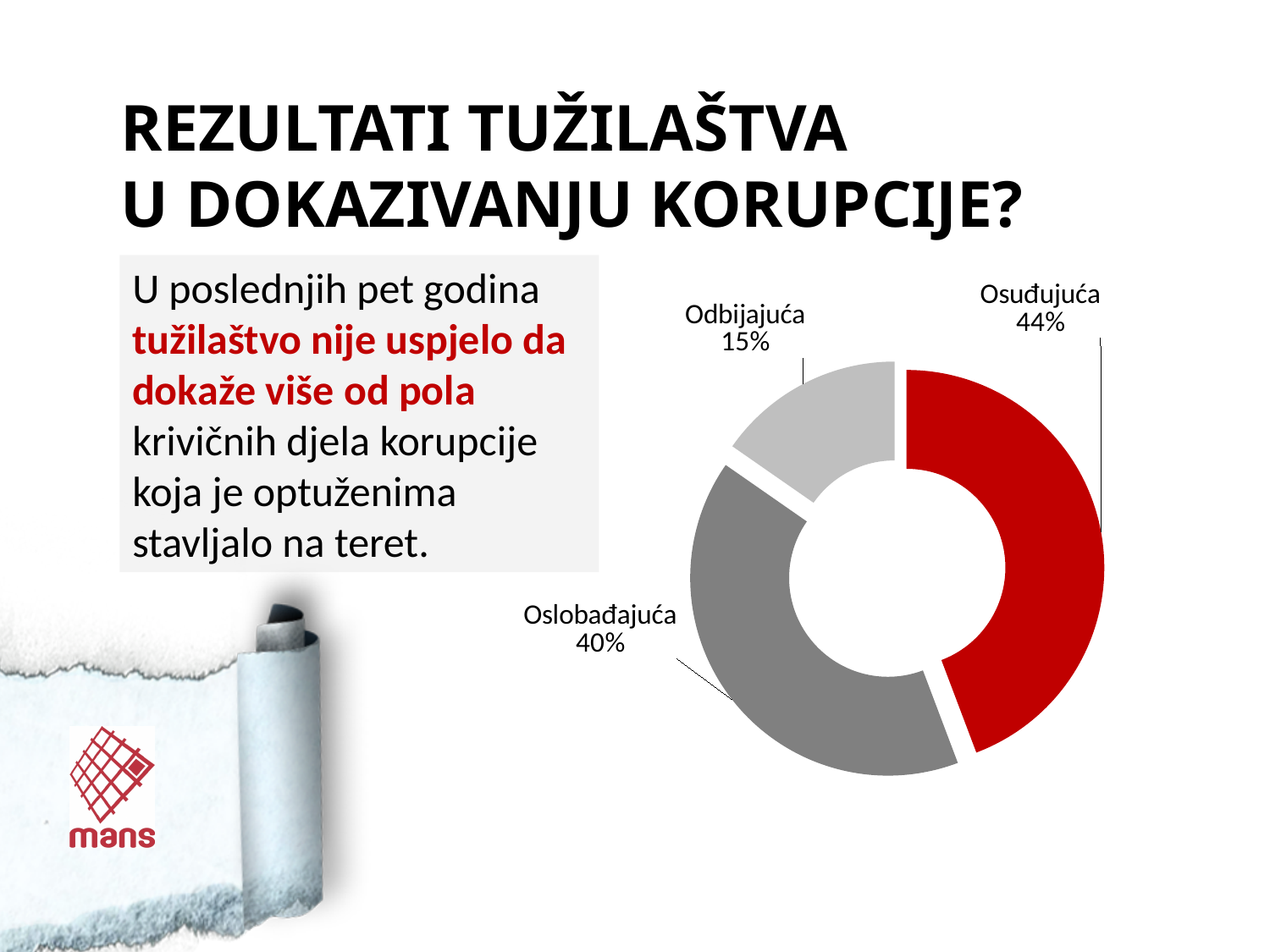
Which is larger, the share for Oslobađajuća or the share for Odbijajuća? Oslobađajuća What is the combined share of Oslobađajuća and Odbijajuća? 55% What kind of chart is shown on the slide? Doughnut chart What is the difference in percentage points between Osuđujuća and Odbijajuća? 29 What share of the doughnut chart is Odbijajuća? 15% What is the difference in percentage points between Oslobađajuća and Odbijajuća? 25 Which category has the smallest slice in the chart? Odbijajuća What colour is the Osuđujuća slice in the chart? Red What share of the doughnut chart is Osuđujuća? 44% How many categories are shown in the chart? 3 What share of the doughnut chart is Oslobađajuća? 40% Which category has the largest slice in the chart? Osuđujuća